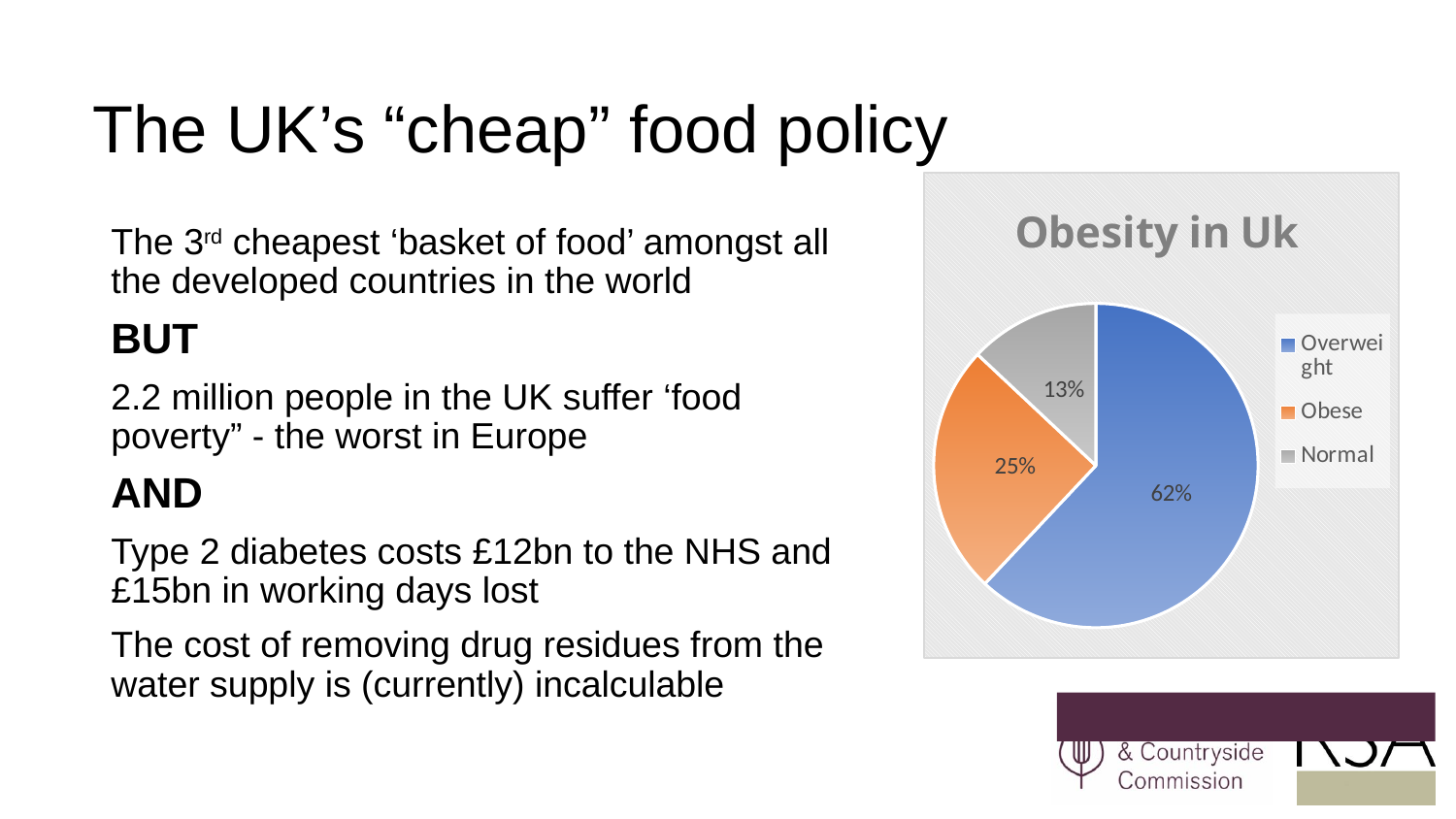
How many categories does the legend list? 3 Which is larger, the Obese slice or the Normal slice? Obese What kind of chart is shown on the slide? Pie chart What colour is the Obese slice in the pie chart? Orange What is the difference in percentage points between the Overweight and Obese slices? 37 What is the combined share of the Obese and Normal slices? 38% What percentage of the pie is labelled for the Normal slice? 13% Which category has the smallest share of the pie? Normal Which category has the largest share of the pie? Overweight What percentage of the pie is labelled for the Obese slice? 25% What percentage of the pie is labelled for the Overweight slice? 62% What is the title of the chart? Obesity in Uk